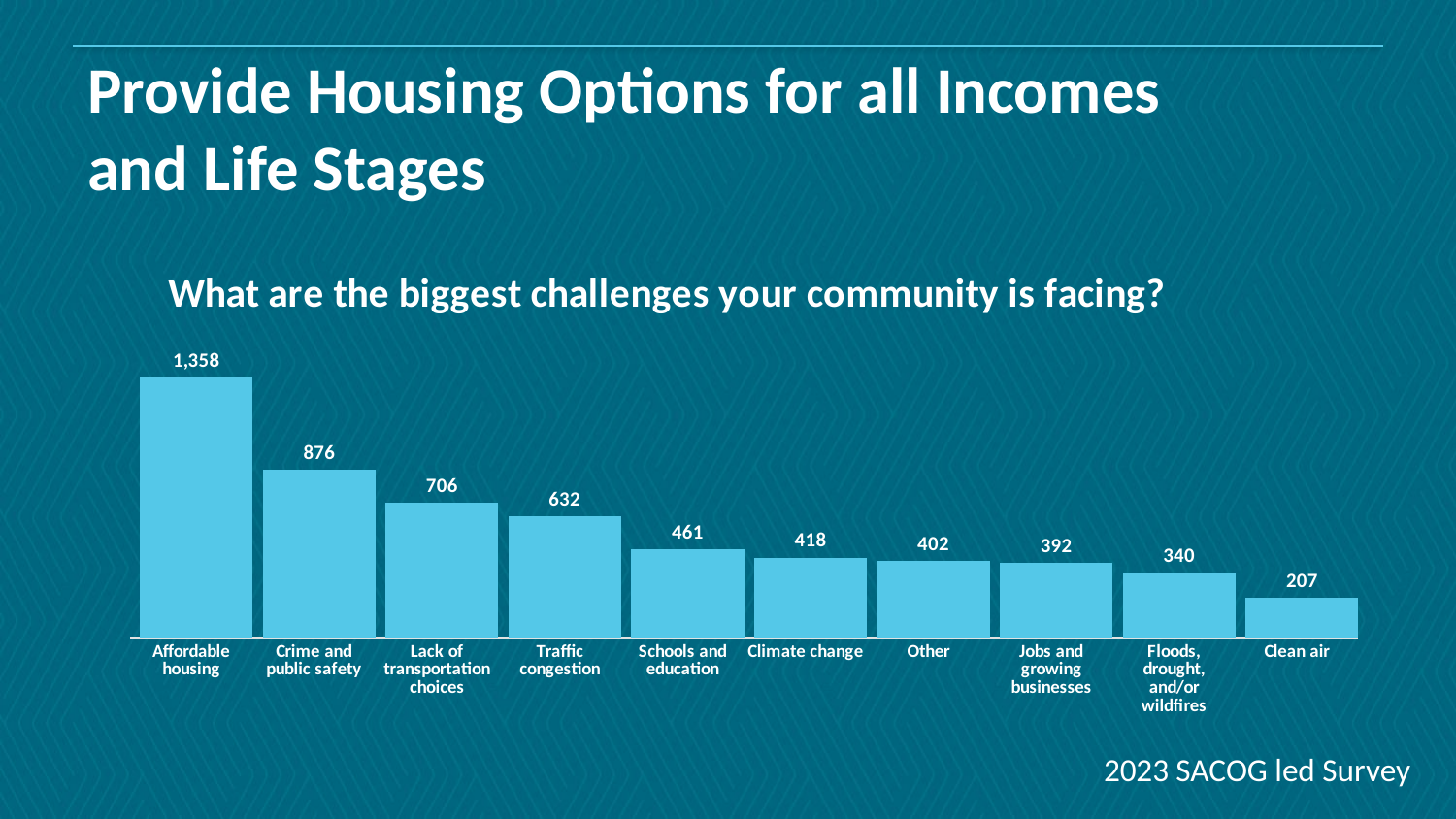
Which is larger, the value for Lack of transportation choices or the value for Other? Lack of transportation choices What question does the chart's title ask? What are the biggest challenges your community is facing? What is the difference between the values for Affordable housing and Crime and public safety? 482 What is the value for Affordable housing? 1,358 Which category has the highest value? Affordable housing Which category has the lowest value? Clean air What is the difference between the values for Schools and education and Climate change? 43 What kind of chart is shown on the slide? Bar chart What is the value for Traffic congestion? 632 How many categories are shown in the chart? 10 What is the value for Floods, drought, and/or wildfires? 340 Do the values rise or fall from left to right along the x axis? Fall